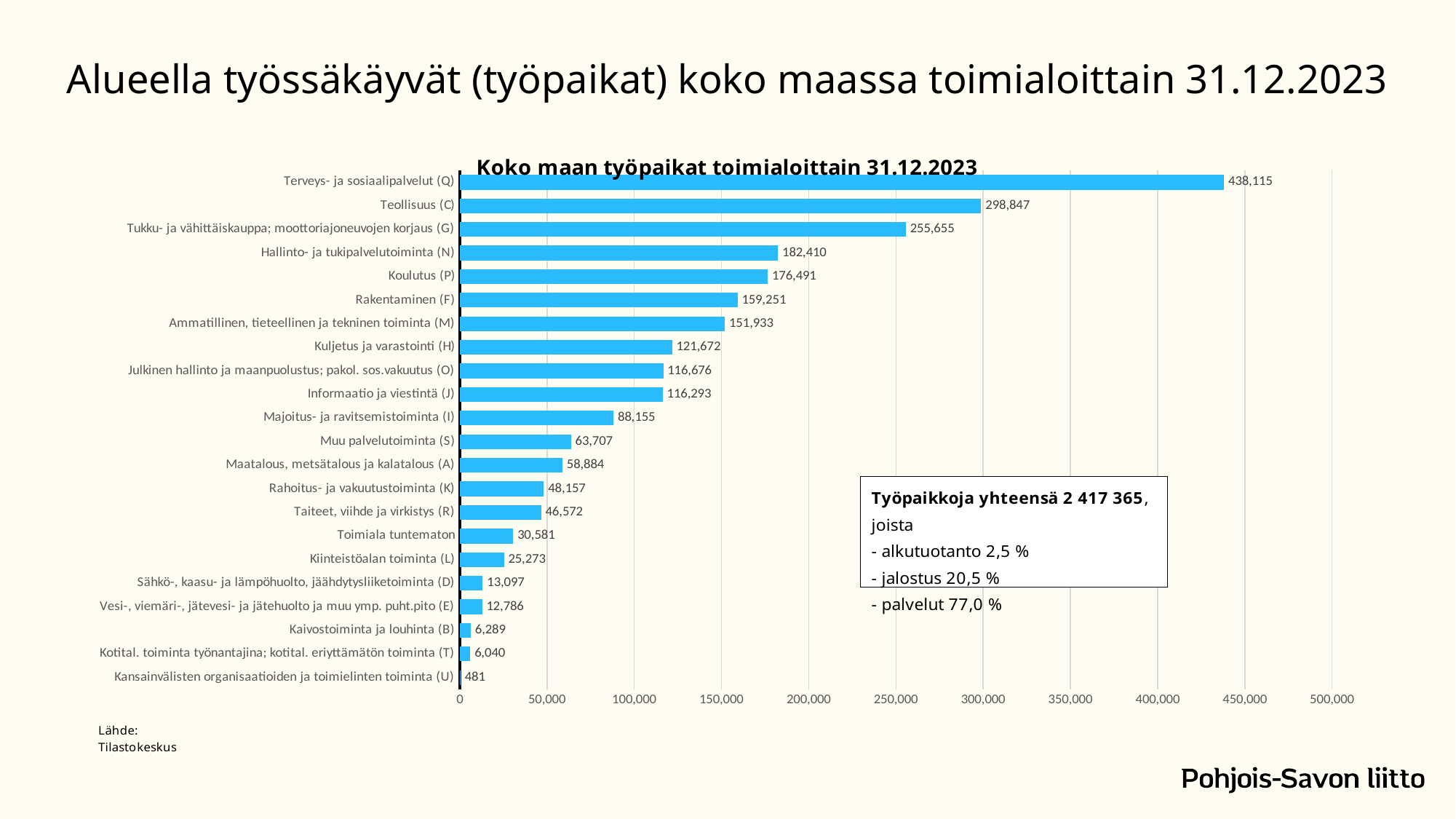
What is the difference between Terveys- ja sosiaalipalvelut (Q) and Teollisuus (C)? 139,268 Which is larger, Rakentaminen (F) or Majoitus- ja ravitsemistoiminta (I)? Rakentaminen (F) What is the value for Kaivostoiminta ja louhinta (B)? 6,289 What is the value for Kuljetus ja varastointi (H)? 121,672 What is the title of the chart? Koko maan työpaikat toimialoittain 31.12.2023 What is the value for Teollisuus (C)? 298,847 What is the difference between Hallinto- ja tukipalvelutoiminta (N) and Koulutus (P)? 5,919 Which category has the highest value? Terveys- ja sosiaalipalvelut (Q) What kind of chart is shown on the slide? Bar chart How many categories are shown in the chart? 22 Which category has the lowest value? Kansainvälisten organisaatioiden ja toimielinten toiminta (U) What is the value for Koulutus (P)? 176,491